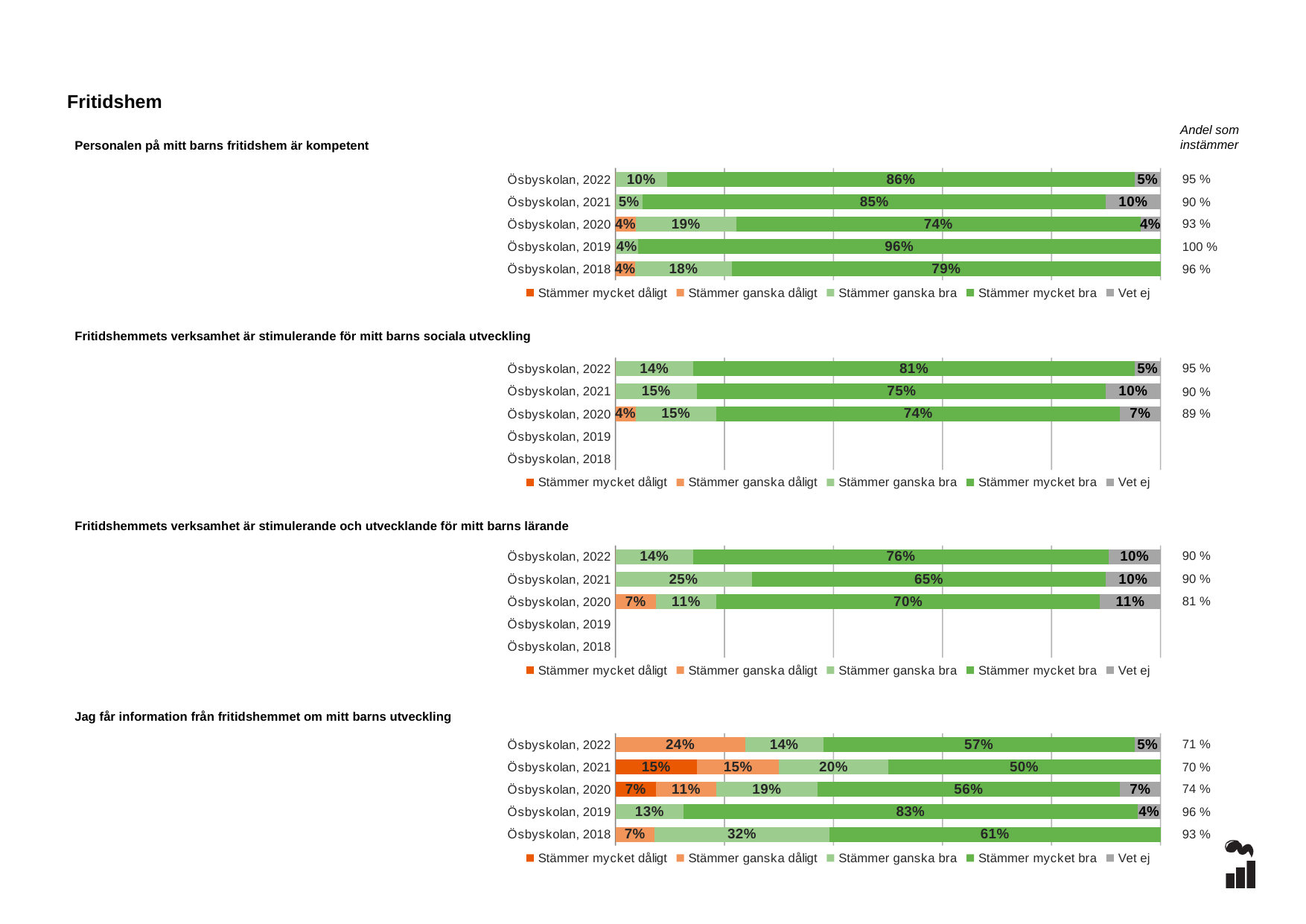
In the chart 'Jag får information från fritidshemmet om mitt barns utveckling', what is the 'Stämmer mycket dåligt' value for Ösbyskolan, 2021? 15% In the chart 'Fritidshemmets verksamhet är stimulerande och utvecklande för mitt barns lärande', which year has the lowest 'Stämmer mycket bra' value? Ösbyskolan, 2021 In the chart 'Personalen på mitt barns fritidshem är kompetent', what is the difference between the 'Stämmer mycket bra' values for Ösbyskolan, 2019 and Ösbyskolan, 2018? 17% In the chart 'Personalen på mitt barns fritidshem är kompetent', what is the 'Stämmer mycket bra' value for Ösbyskolan, 2022? 86% What kind of chart is 'Jag får information från fritidshemmet om mitt barns utveckling'? Stacked bar chart In the chart 'Fritidshemmets verksamhet är stimulerande för mitt barns sociala utveckling', what is the 'Vet ej' value for Ösbyskolan, 2021? 10% In the chart 'Jag får information från fritidshemmet om mitt barns utveckling', which is larger: the 'Stämmer mycket bra' value for Ösbyskolan, 2019 or for Ösbyskolan, 2018? Ösbyskolan, 2019 How many series does the legend list in the chart 'Personalen på mitt barns fritidshem är kompetent'? 5 In the chart 'Jag får information från fritidshemmet om mitt barns utveckling', what is the 'Stämmer ganska dåligt' value for Ösbyskolan, 2022? 24% In the chart 'Personalen på mitt barns fritidshem är kompetent', which year has the highest 'Stämmer mycket bra' value? Ösbyskolan, 2019 In the chart 'Fritidshemmets verksamhet är stimulerande för mitt barns sociala utveckling', how many years have data plotted? 3 In the chart 'Fritidshemmets verksamhet är stimulerande och utvecklande för mitt barns lärande', what is the 'Stämmer ganska bra' value for Ösbyskolan, 2021? 25%